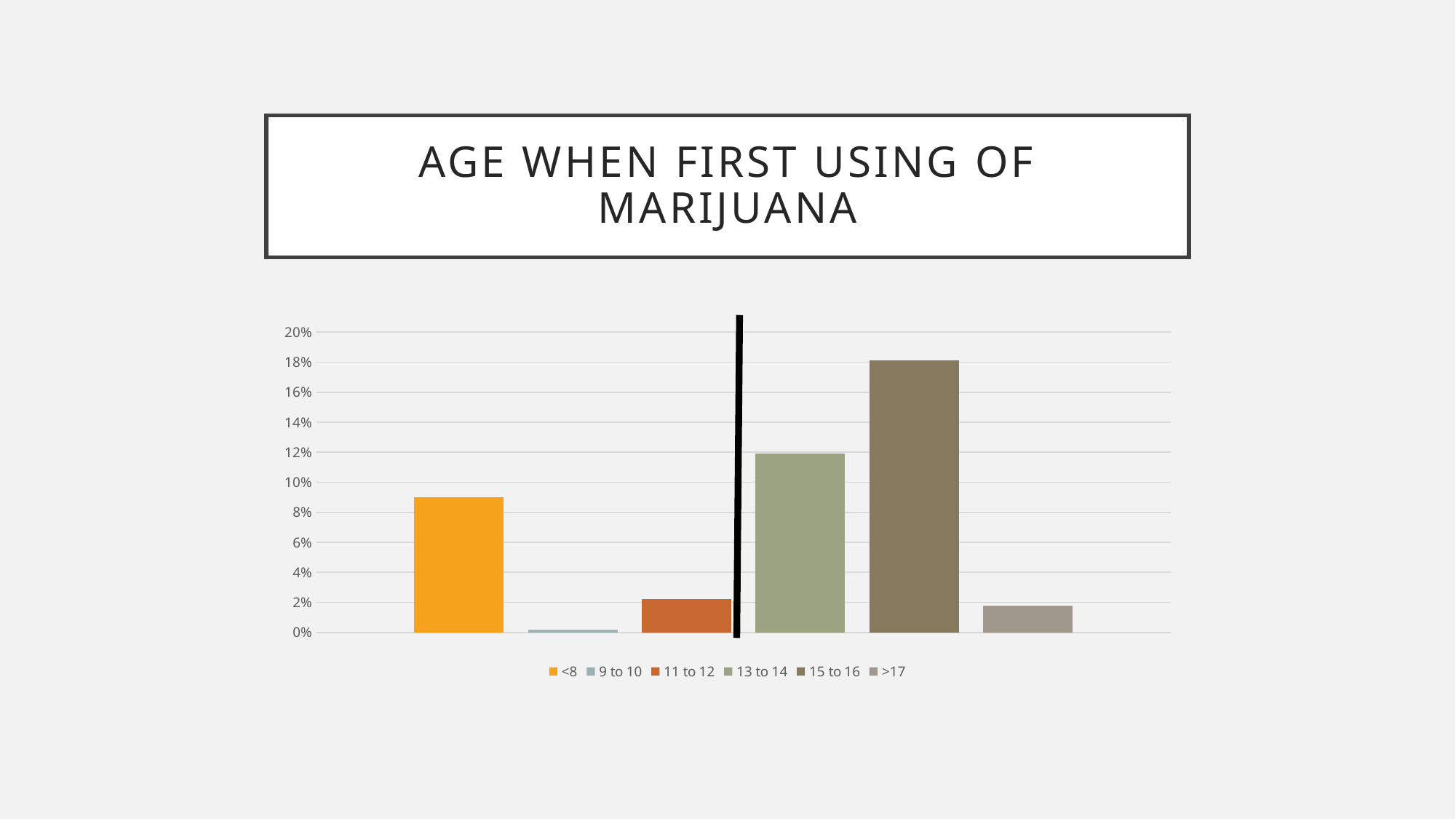
Is the value for >17 greater or less than 4%? less What is the title of the slide? AGE WHEN FIRST USING OF MARIJUANA Which is larger, the value for <8 or the value for 13 to 14? 13 to 14 Which age group has the lowest value? 9 to 10 How many series does the legend list? 6 Is the value for 13 to 14 greater or less than 10%? greater Is the value for <8 greater or less than 6%? greater Which age group has the highest value? 15 to 16 How many bars are plotted in the chart? 6 What type of chart is shown on the slide? bar chart